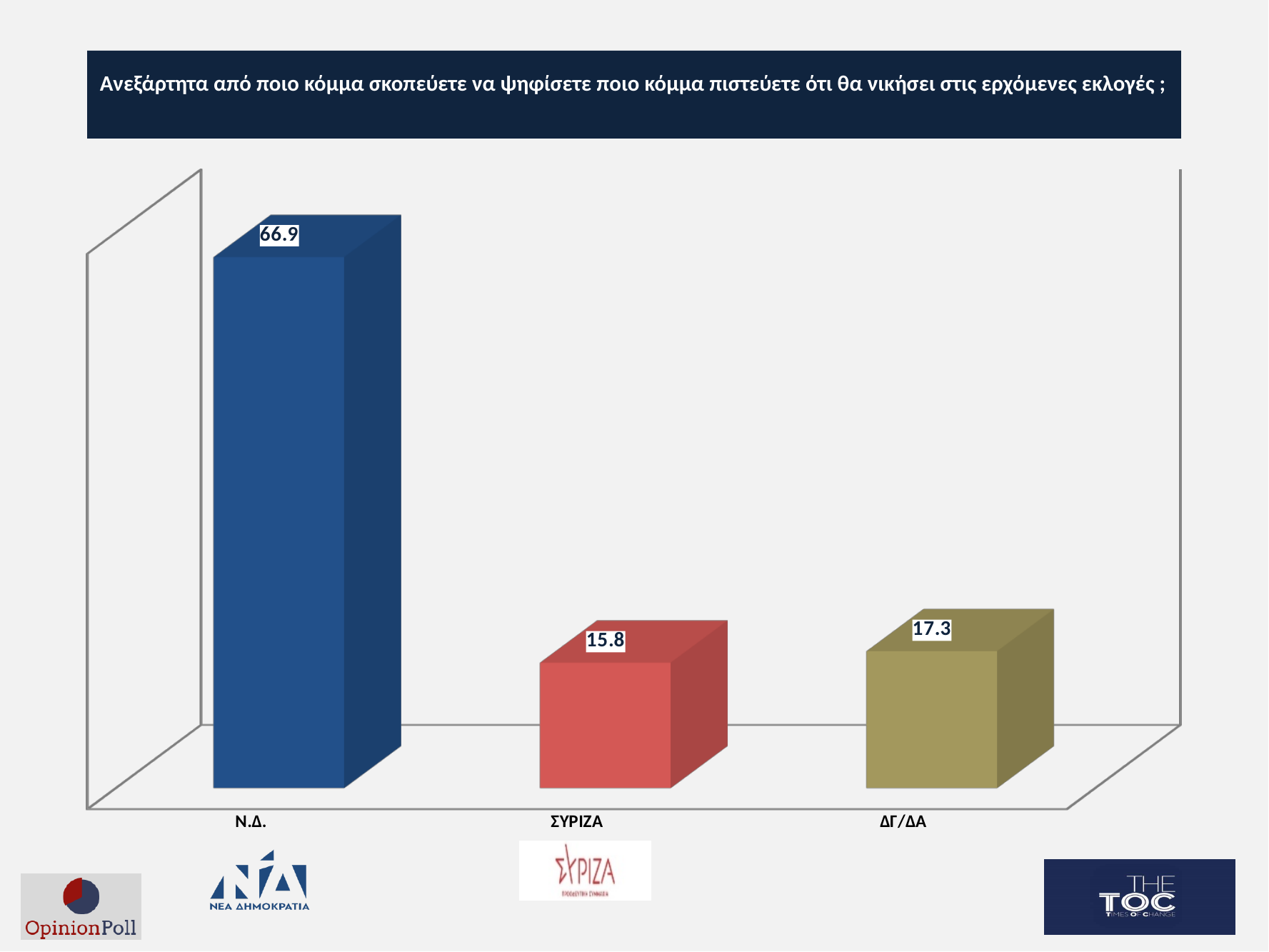
Which is larger, the value for ΔΓ/ΔΑ or the value for ΣΥΡΙΖΑ? ΔΓ/ΔΑ What is the difference between the values for Ν.Δ. and ΣΥΡΙΖΑ? 51.1 What is the value for ΣΥΡΙΖΑ? 15.8 What colour is the bar for ΣΥΡΙΖΑ? Red How many categories are shown on the chart? 3 Which category has the lowest value? ΣΥΡΙΖΑ Which is larger, the value for Ν.Δ. or the value for ΔΓ/ΔΑ? Ν.Δ. What is the value for ΔΓ/ΔΑ? 17.3 Which category has the highest value? Ν.Δ. What is the difference between the values for ΔΓ/ΔΑ and ΣΥΡΙΖΑ? 1.5 What kind of chart is shown on the slide? Bar chart What is the value for Ν.Δ.? 66.9